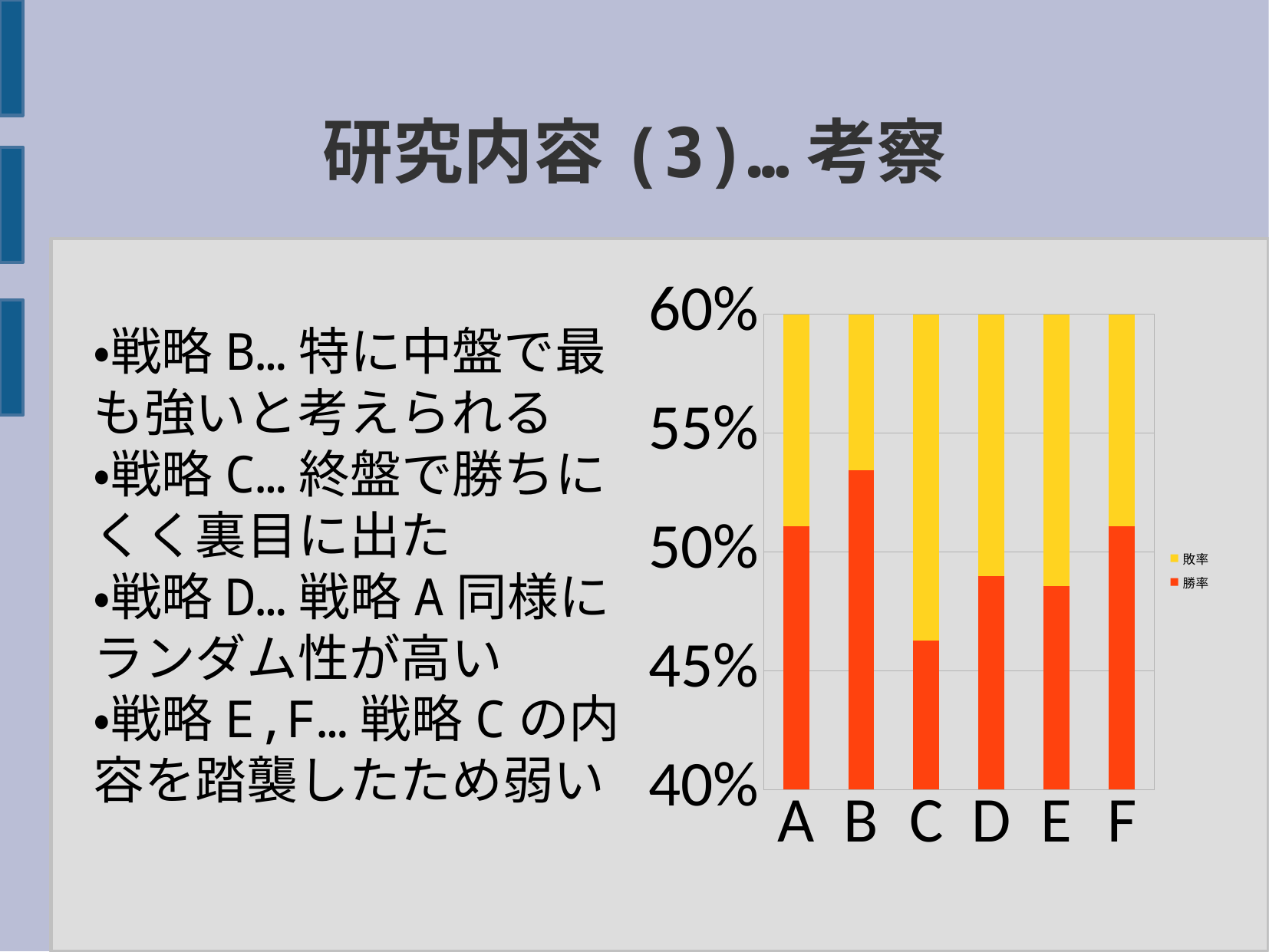
Which category has the lowest 勝率 (red bar)? C What kind of chart is shown on the slide? stacked bar chart How many categories are shown on the x axis of the chart? 6 Is the 勝率 value for E greater or less than 45%? greater How many series does the chart legend list? 2 Which series is shown in red in the chart? 勝率 Is the 勝率 value for B greater or less than 50%? greater Which category has the highest 勝率 (red bar)? B Is the 勝率 value for D greater or less than 50%? less Which has the larger 勝率, D or C? D Which has the larger 勝率, B or C? B